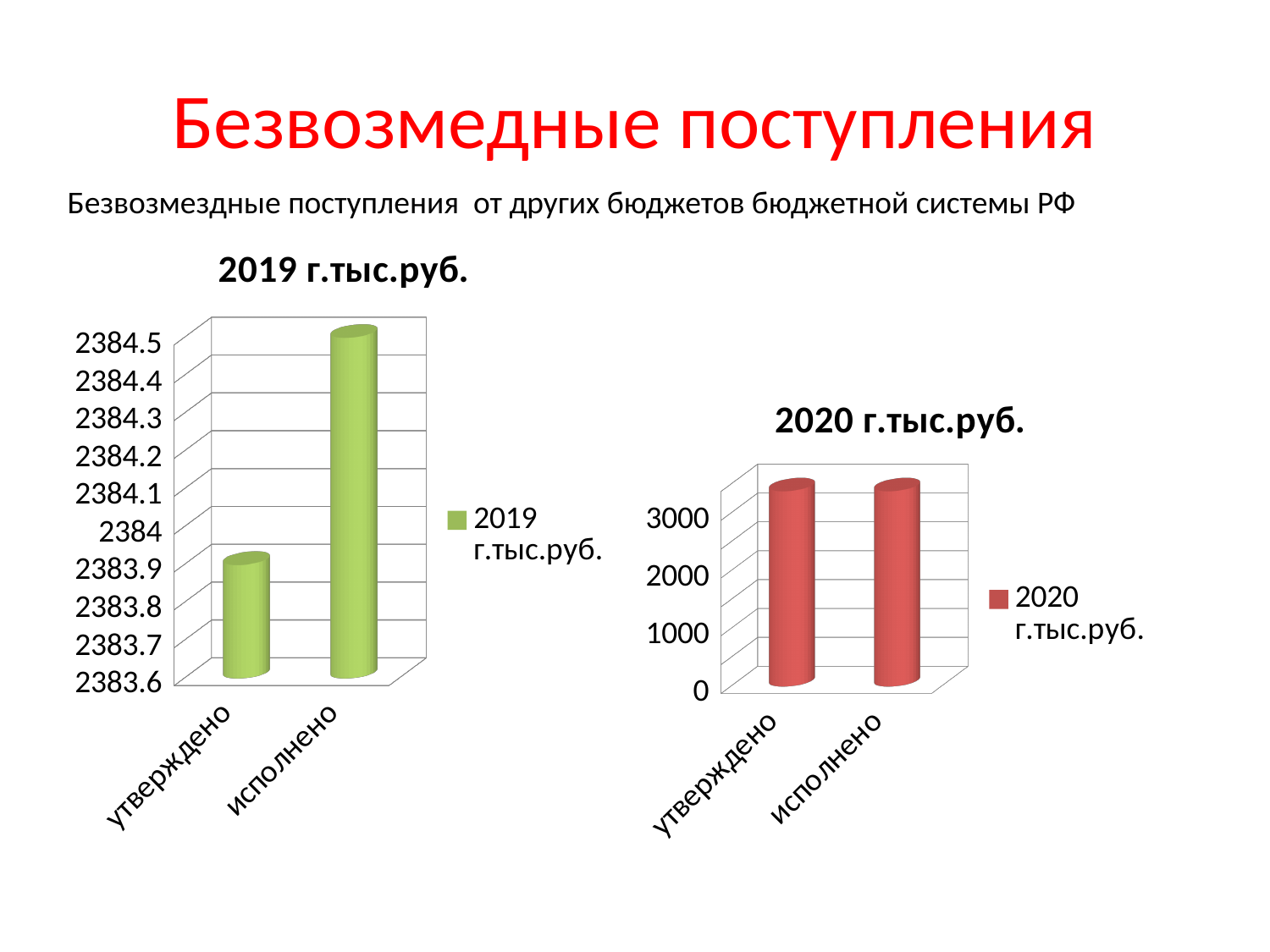
In the "2019 г.тыс.руб." chart, which is larger: утверждено or исполнено? исполнено In the "2020 г.тыс.руб." chart, how many series does the legend list? 1 In the "2019 г.тыс.руб." chart, is the value for исполнено greater or less than 2384.2? greater In the "2019 г.тыс.руб." chart, how many categories are shown on the x axis? 2 In the "2019 г.тыс.руб." chart, is the value for утверждено greater or less than 2384? less In the "2020 г.тыс.руб." chart, is the value for исполнено greater or less than 2000? greater In the "2019 г.тыс.руб." chart, which category has the highest value? исполнено What kind of chart is the "2019 г.тыс.руб." chart? bar chart What legend entry is shown for the "2020 г.тыс.руб." chart? 2020 г.тыс.руб. In the "2019 г.тыс.руб." chart, which category has the lowest value? утверждено What kind of chart is the "2020 г.тыс.руб." chart? bar chart